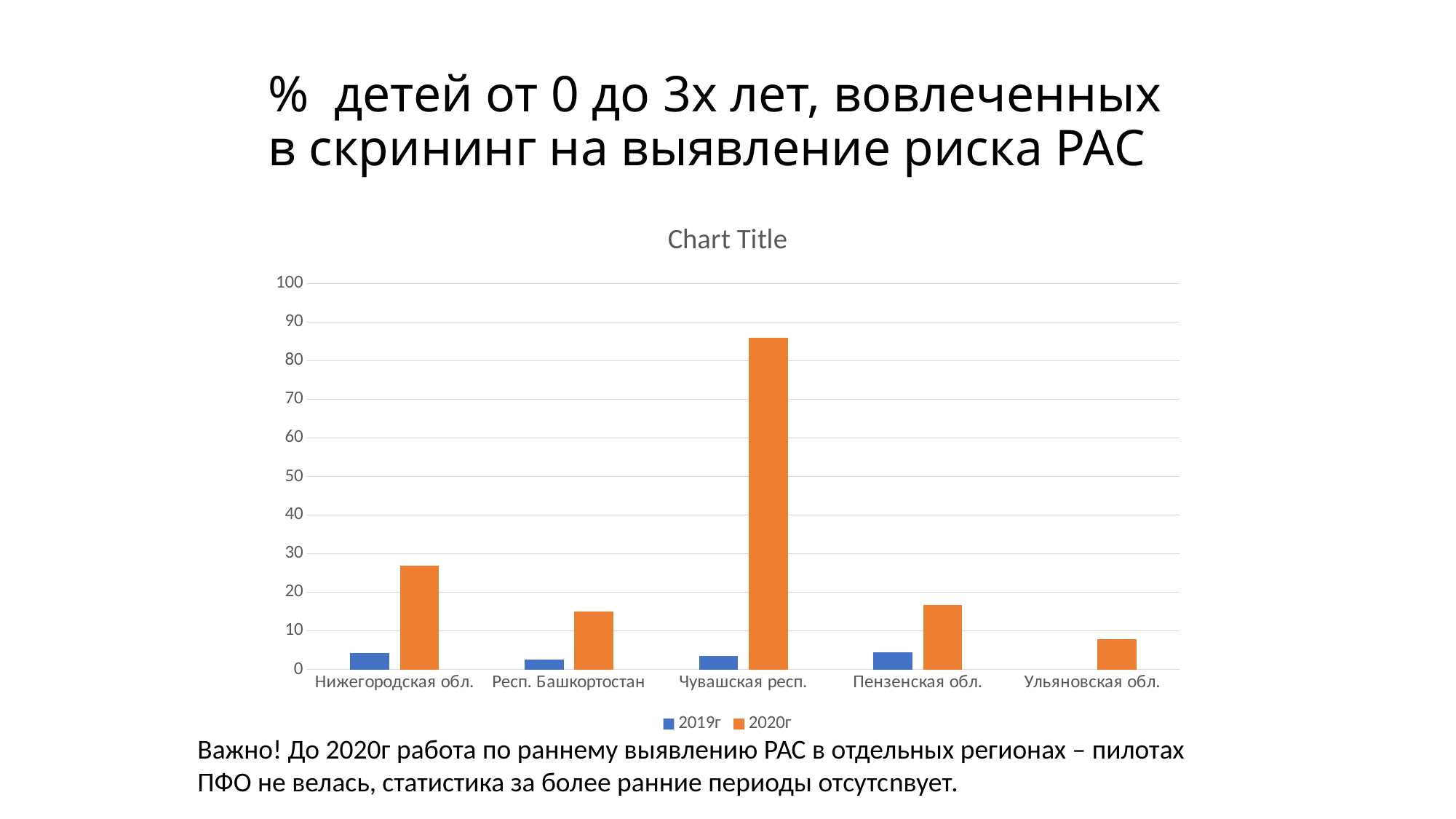
What kind of chart is shown on the slide? bar chart Is the 2020г value for Нижегородская обл. greater or less than 20? greater Which is larger for Пензенская обл.: the 2019г value or the 2020г value? 2020г What are the two series names listed in the chart legend? 2019г and 2020г Which is larger: the 2020г value for Нижегородская обл. or the 2020г value for Респ. Башкортостан? Нижегородская обл. Is the 2020г value for Ульяновская обл. greater or less than 10? less How many series does the chart legend list? 2 Is the 2020г value for Чувашская респ. greater or less than 80? greater Which region has the highest value for 2020г? Чувашская респ. How many regions (categories) are shown on the x axis of the chart? 5 Which region has the lowest value for 2020г? Ульяновская обл.